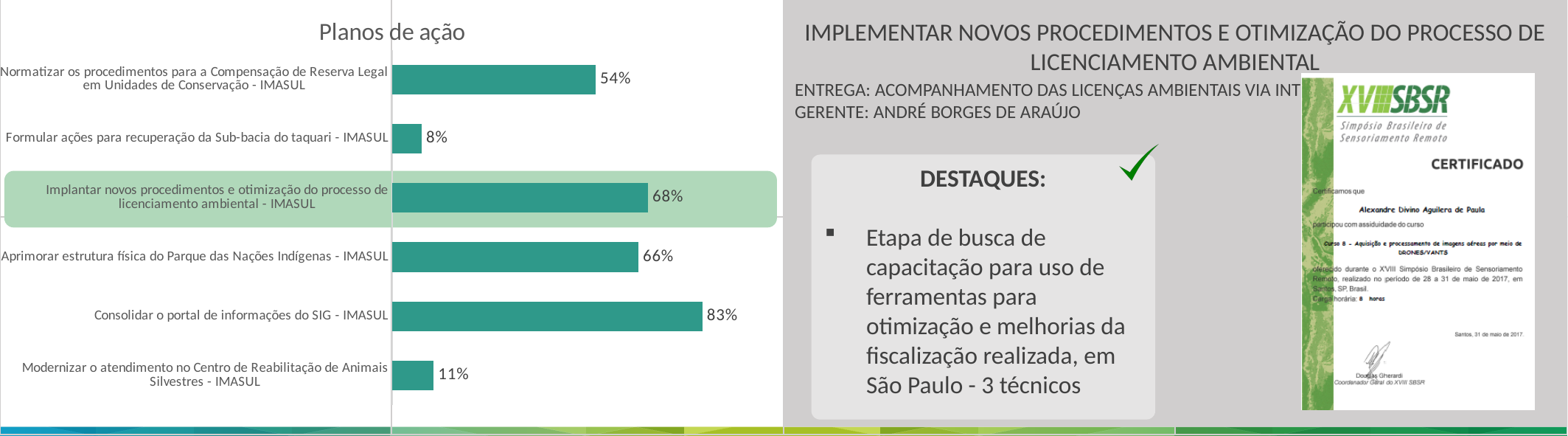
What is the value for "Modernizar o atendimento no Centro de Reabilitação de Animais Silvestres - IMASUL"? 11% What is the title of the chart? Planos de ação What is the difference between the values for "Consolidar o portal de informações do SIG - IMASUL" and "Normatizar os procedimentos para a Compensação de Reserva Legal em Unidades de Conservação - IMASUL"? 29% What is the value for "Implantar novos procedimentos e otimização do processo de licenciamento ambiental - IMASUL"? 68% How many action plans (categories) are shown in the chart? 6 Which category in the chart is highlighted with a green background? Implantar novos procedimentos e otimização do processo de licenciamento ambiental - IMASUL Which action plan has the highest value in the chart? Consolidar o portal de informações do SIG - IMASUL What is the value for "Consolidar o portal de informações do SIG - IMASUL" in the Planos de ação chart? 83% What kind of chart is shown on the slide? Bar chart Which action plan has the lowest value in the chart? Formular ações para recuperação da Sub-bacia do taquari - IMASUL What is the value for "Formular ações para recuperação da Sub-bacia do taquari - IMASUL"? 8% Which is larger: the value for "Aprimorar estrutura física do Parque das Nações Indígenas - IMASUL" or for "Normatizar os procedimentos para a Compensação de Reserva Legal em Unidades de Conservação - IMASUL"? Aprimorar estrutura física do Parque das Nações Indígenas - IMASUL